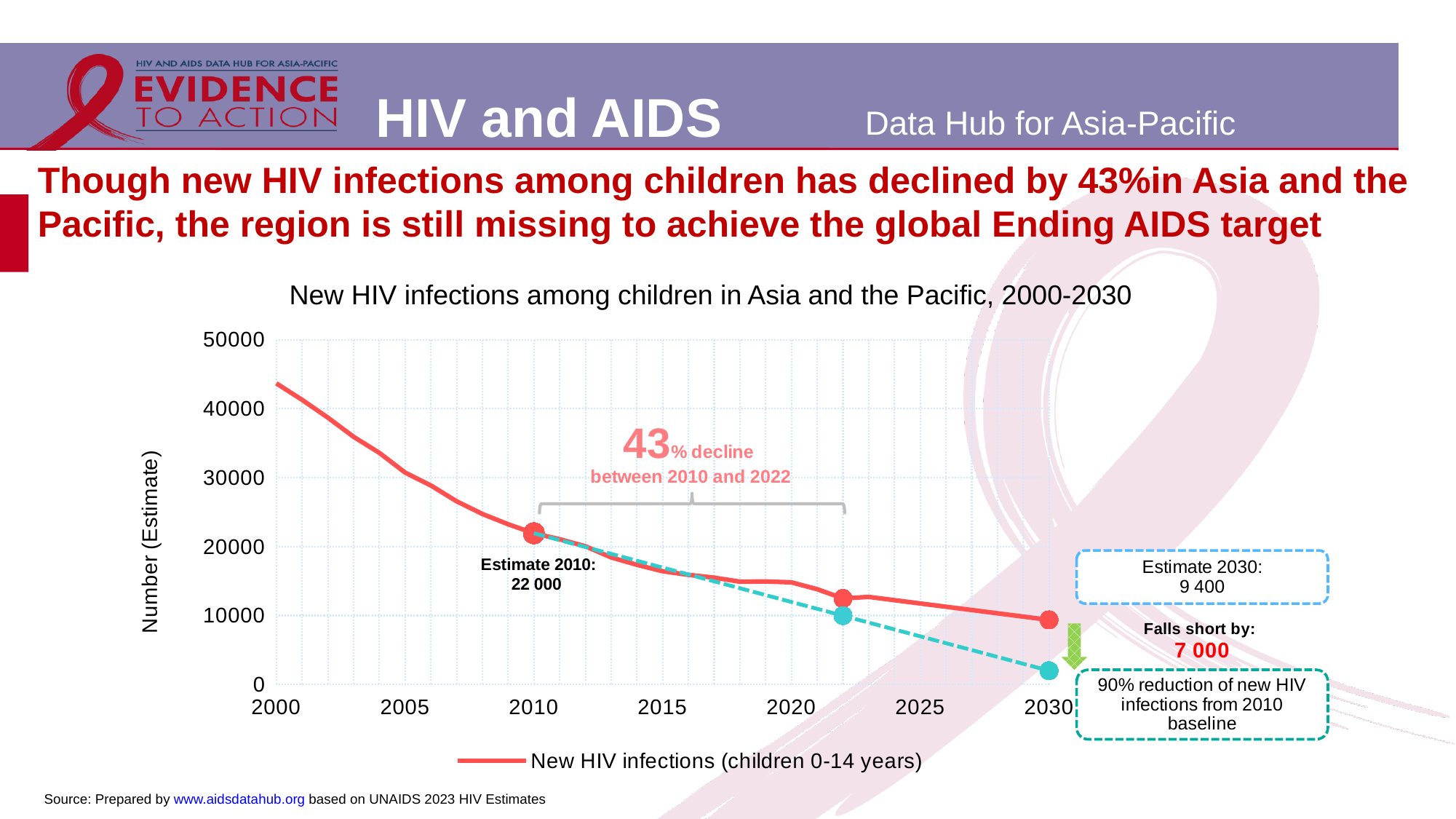
Do the values of new HIV infections among children rise or fall from 2000 to 2030? fall What is the estimated number of new HIV infections among children in 2010? 22 000 What is the difference between the 2010 estimate and the 2030 estimate? 12 600 What type of chart is shown on the slide? line chart What is the percentage decline in new HIV infections among children between 2010 and 2022? 43% How many series does the chart legend list? 1 Is the value for 2000 greater or less than 40000? greater Is the value for 2022 greater or less than 10000? greater What is the title of the chart? New HIV infections among children in Asia and the Pacific, 2000-2030 By how much does the 2030 estimate fall short of the target? 7 000 What is the estimated number of new HIV infections among children in 2030? 9 400 What is the label of the y axis? Number (Estimate)